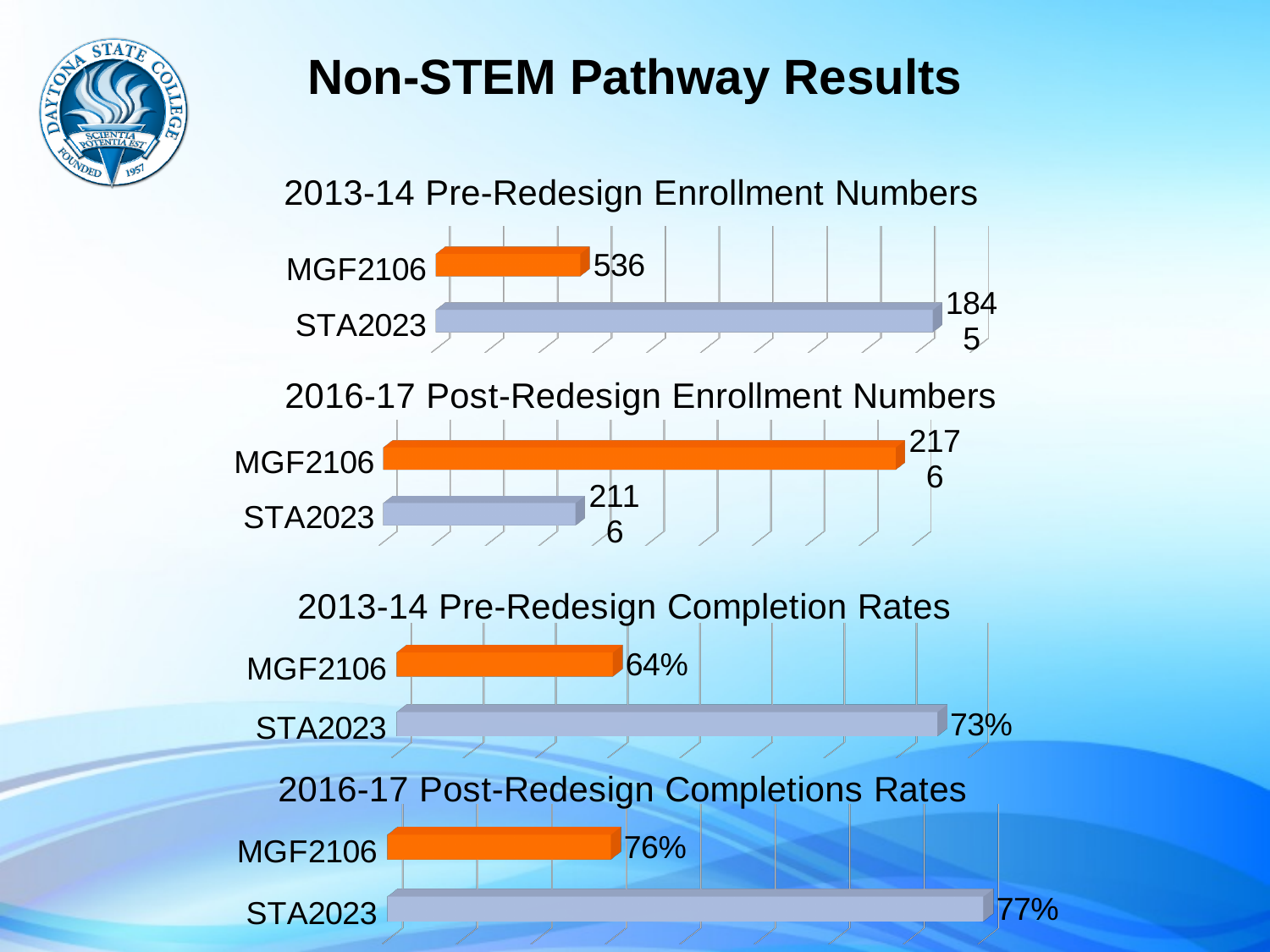
In the 2013-14 Pre-Redesign Enrollment Numbers chart, what is the value for STA2023? 1845 In the 2013-14 Pre-Redesign Completion Rates chart, what is the completion rate for MGF2106? 64% What kind of chart is the 2016-17 Post-Redesign Completions Rates chart? Bar chart In the 2013-14 Pre-Redesign Enrollment Numbers chart, what is the value for MGF2106? 536 In the 2016-17 Post-Redesign Enrollment Numbers chart, what is the difference between the MGF2106 and STA2023 enrollments? 60 In the 2016-17 Post-Redesign Enrollment Numbers chart, what is the value for STA2023? 2116 In the 2016-17 Post-Redesign Enrollment Numbers chart, what is the value for MGF2106? 2176 In the 2016-17 Post-Redesign Enrollment Numbers chart, which course has the lower enrollment? STA2023 In the 2013-14 Pre-Redesign Completion Rates chart, what is the difference between the STA2023 and MGF2106 completion rates? 9% In the 2013-14 Pre-Redesign Enrollment Numbers chart, which course has the higher enrollment? STA2023 In the 2016-17 Post-Redesign Completions Rates chart, what is the completion rate for STA2023? 77% In the 2013-14 Pre-Redesign Completion Rates chart, is the completion rate for MGF2106 or STA2023 larger? STA2023